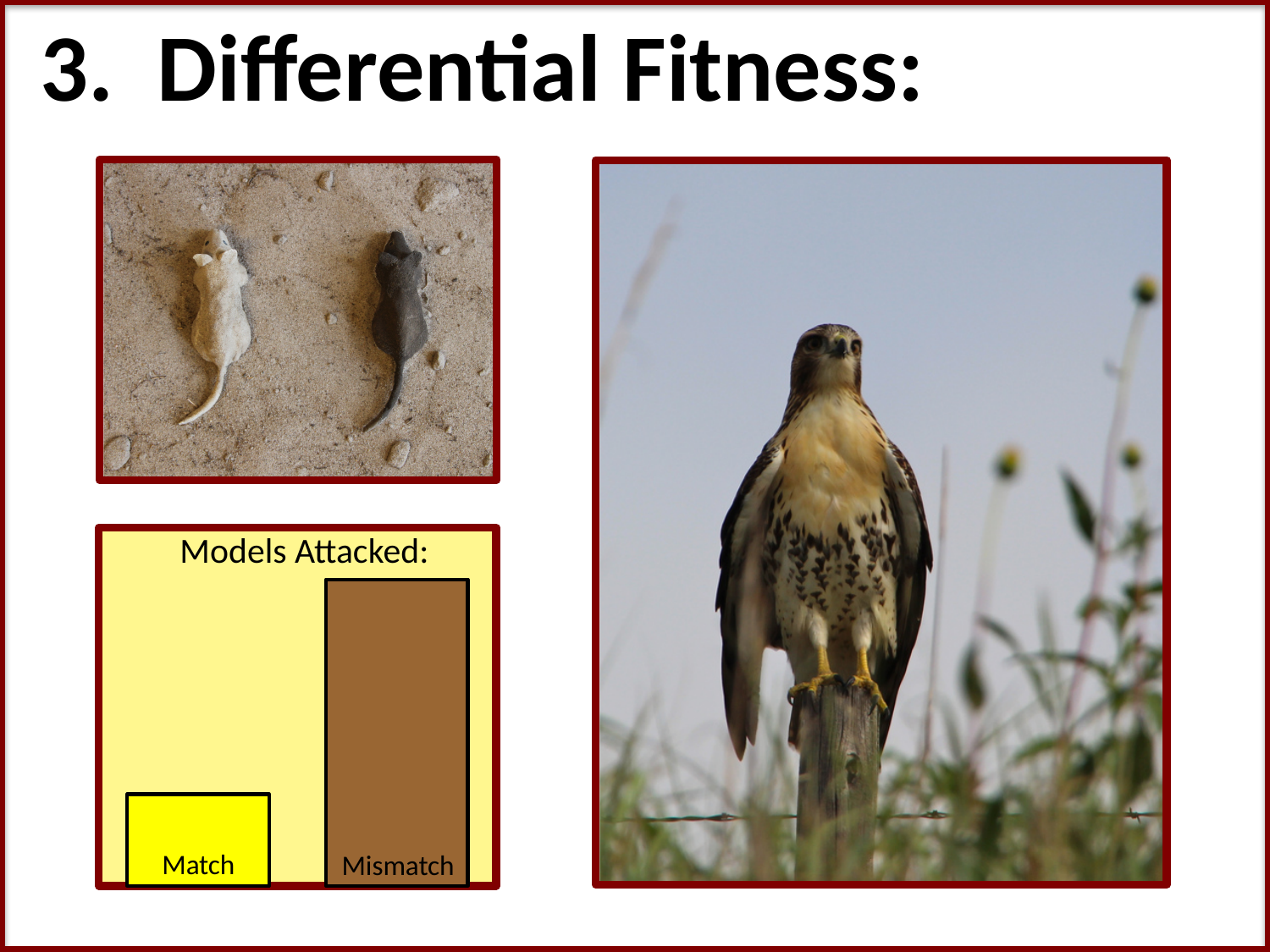
What colour is the Mismatch bar in the "Models Attacked:" chart? brown What kind of chart is shown under the heading "Models Attacked:"? bar chart What is the title of the bar chart on the slide? Models Attacked: How many bars does the "Models Attacked:" chart have? 2 Which category has the highest bar in the "Models Attacked:" chart? Mismatch In the "Models Attacked:" chart, is the bar for Match or Mismatch taller? Mismatch Which category has the lowest bar in the "Models Attacked:" chart? Match